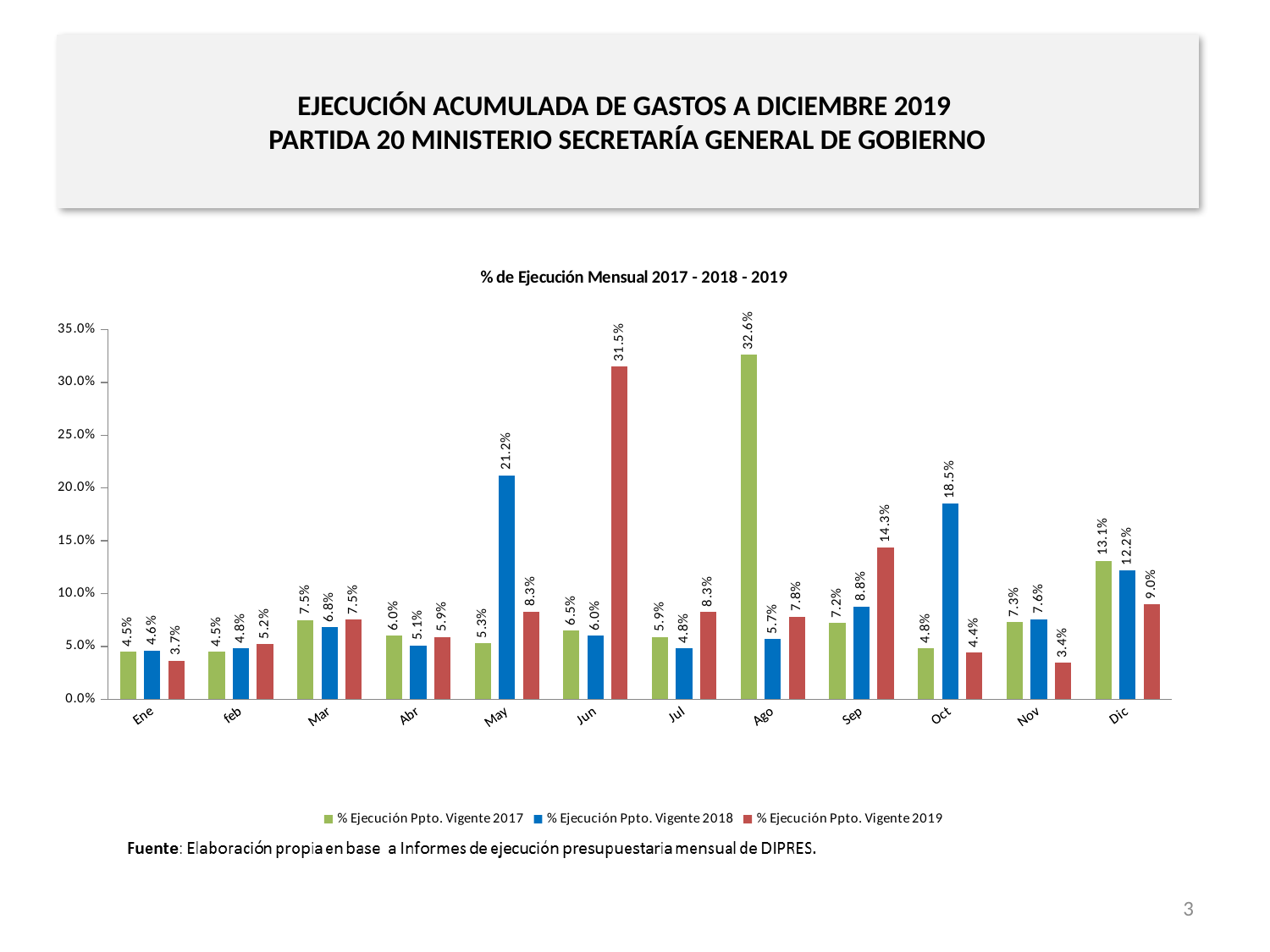
What is the value for % Ejecución Ppto. Vigente 2019 in Nov? 3.4% What is the value for % Ejecución Ppto. Vigente 2019 in Jun? 31.5% Which month has the lowest value for % Ejecución Ppto. Vigente 2019? Nov Is the value for % Ejecución Ppto. Vigente 2019 in Sep greater or less than 10.0%? greater What kind of chart is shown on the slide? Bar chart How many months are shown on the x axis? 12 What is the value for % Ejecución Ppto. Vigente 2017 in Ago? 32.6% How many series does the legend list? 3 What is the value for % Ejecución Ppto. Vigente 2018 in May? 21.2% What is the difference between the 2017 and 2018 values in Dic? 0.9% Which month has the highest value for % Ejecución Ppto. Vigente 2018? May In Oct, which series has the larger value: % Ejecución Ppto. Vigente 2018 or % Ejecución Ppto. Vigente 2019? % Ejecución Ppto. Vigente 2018